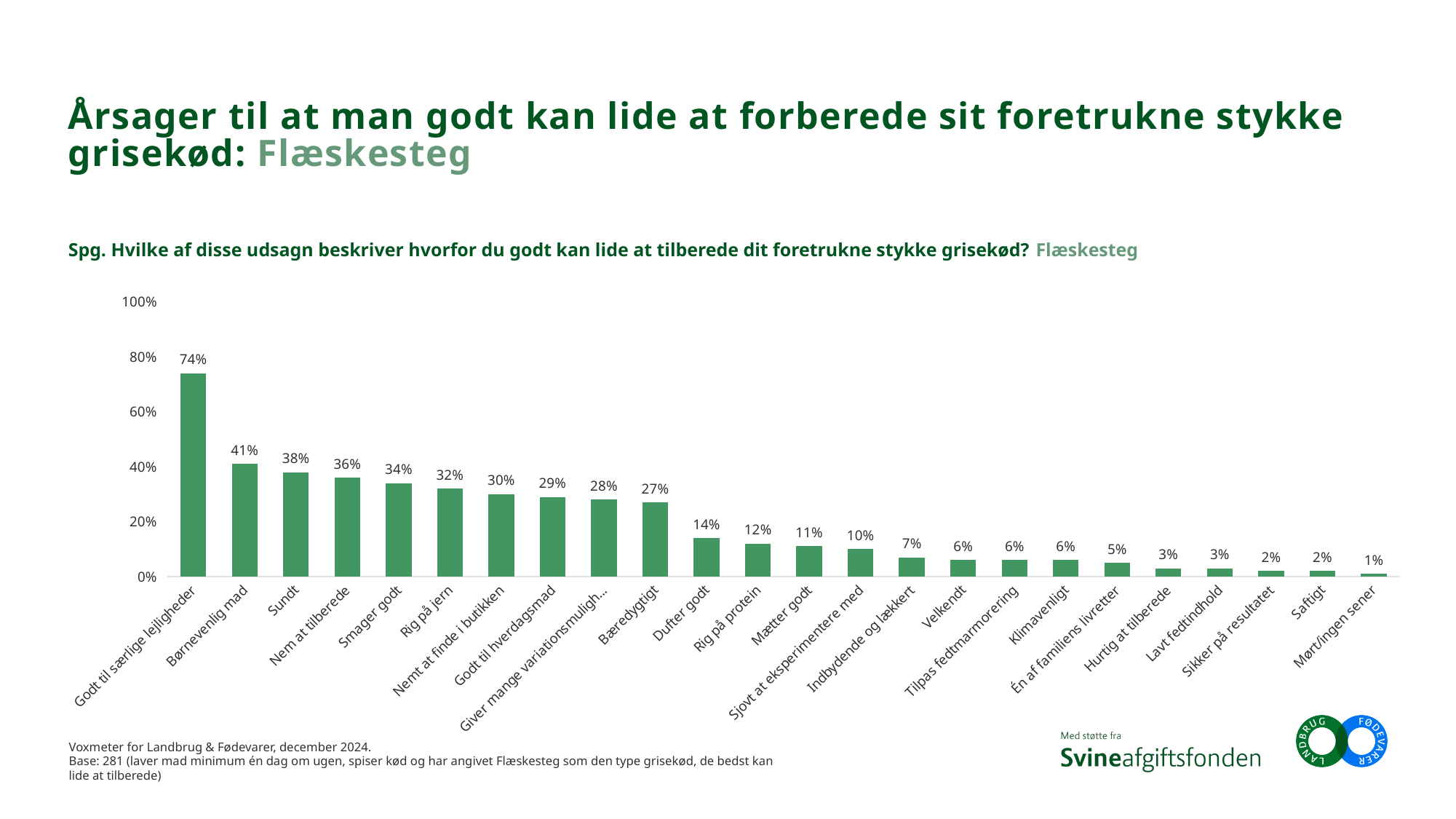
How many categories are shown in the chart? 24 Which category has the lowest value? Mørt/ingen sener What kind of chart is shown on the slide? Bar chart Is the value for "Nem at tilberede" greater or less than 20%? greater What is the value for "Godt til særlige lejligheder"? 74% What is the value for "Smager godt"? 34% Which category has the highest value? Godt til særlige lejligheder What is the difference between the values for "Godt til særlige lejligheder" and "Bæredygtigt"? 47% What is the value for "Klimavenligt"? 6% What is the value for "Dufter godt"? 14% Which is larger, the value for "Rig på jern" or the value for "Rig på protein"? Rig på jern What is the difference between the values for "Børnevenlig mad" and "Sundt"? 3%